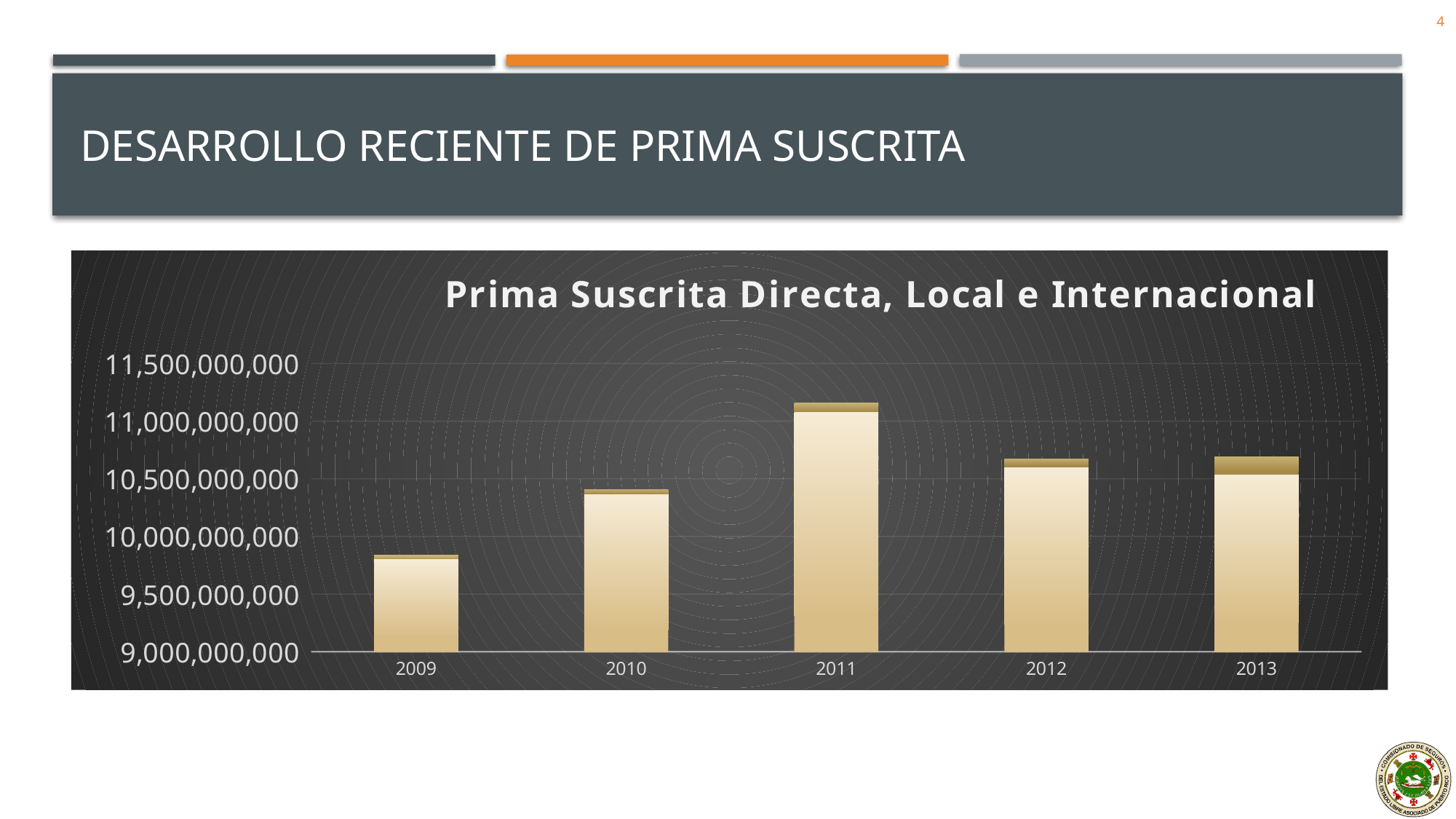
Which year has the highest bar in the chart? 2011 Is the value for 2010 greater or less than 10,000,000,000? greater What is the title of the chart? Prima Suscrita Directa, Local e Internacional Is the value for 2009 greater or less than 10,000,000,000? less Which year has the larger value, 2010 or 2011? 2011 Is the value for 2011 greater or less than 11,000,000,000? greater Do the values rise or fall from 2009 to 2011? rise What kind of chart is shown on the slide? Bar chart Which year has the lowest bar in the chart? 2009 Which year has the larger value, 2009 or 2012? 2012 How many years are shown on the x axis of the chart? 5